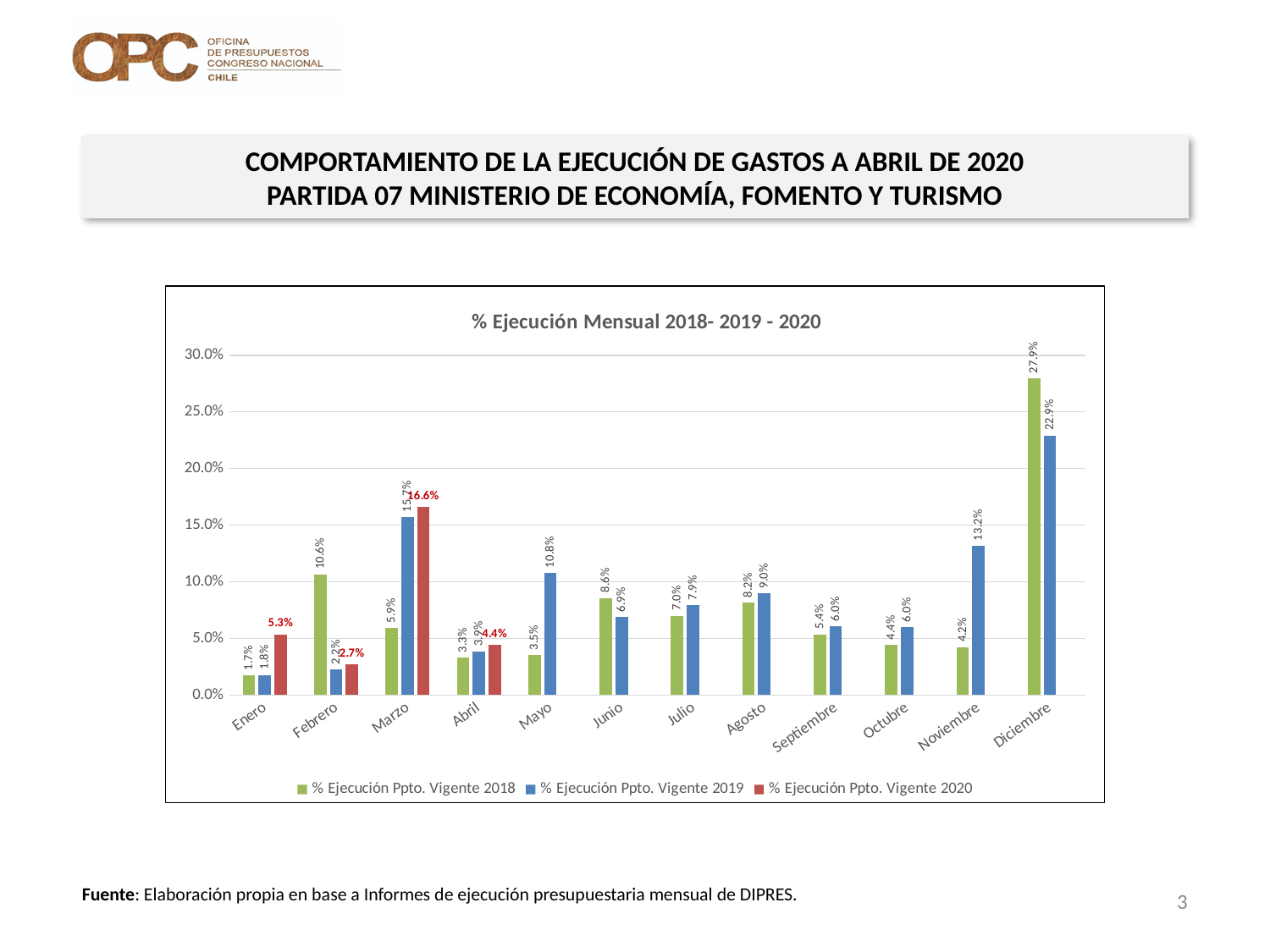
What is the difference between the 2018 and 2019 values in Diciembre? 5.0% Which month has the lowest value for % Ejecución Ppto. Vigente 2018? Enero Which month has the highest value for % Ejecución Ppto. Vigente 2019? Diciembre Which is larger in Febrero: the 2018 value or the 2019 value? 2018 value Is the value for % Ejecución Ppto. Vigente 2019 in Mayo greater or less than 10.0%? greater What is the value for % Ejecución Ppto. Vigente 2019 in Noviembre? 13.2% How many months are shown on the x axis? 12 What is the value for % Ejecución Ppto. Vigente 2018 in Diciembre? 27.9% How many series does the legend list? 3 What kind of chart is shown on the slide? Bar chart What is the value for % Ejecución Ppto. Vigente 2020 in Marzo? 16.6% What is the value for % Ejecución Ppto. Vigente 2020 in Enero? 5.3%